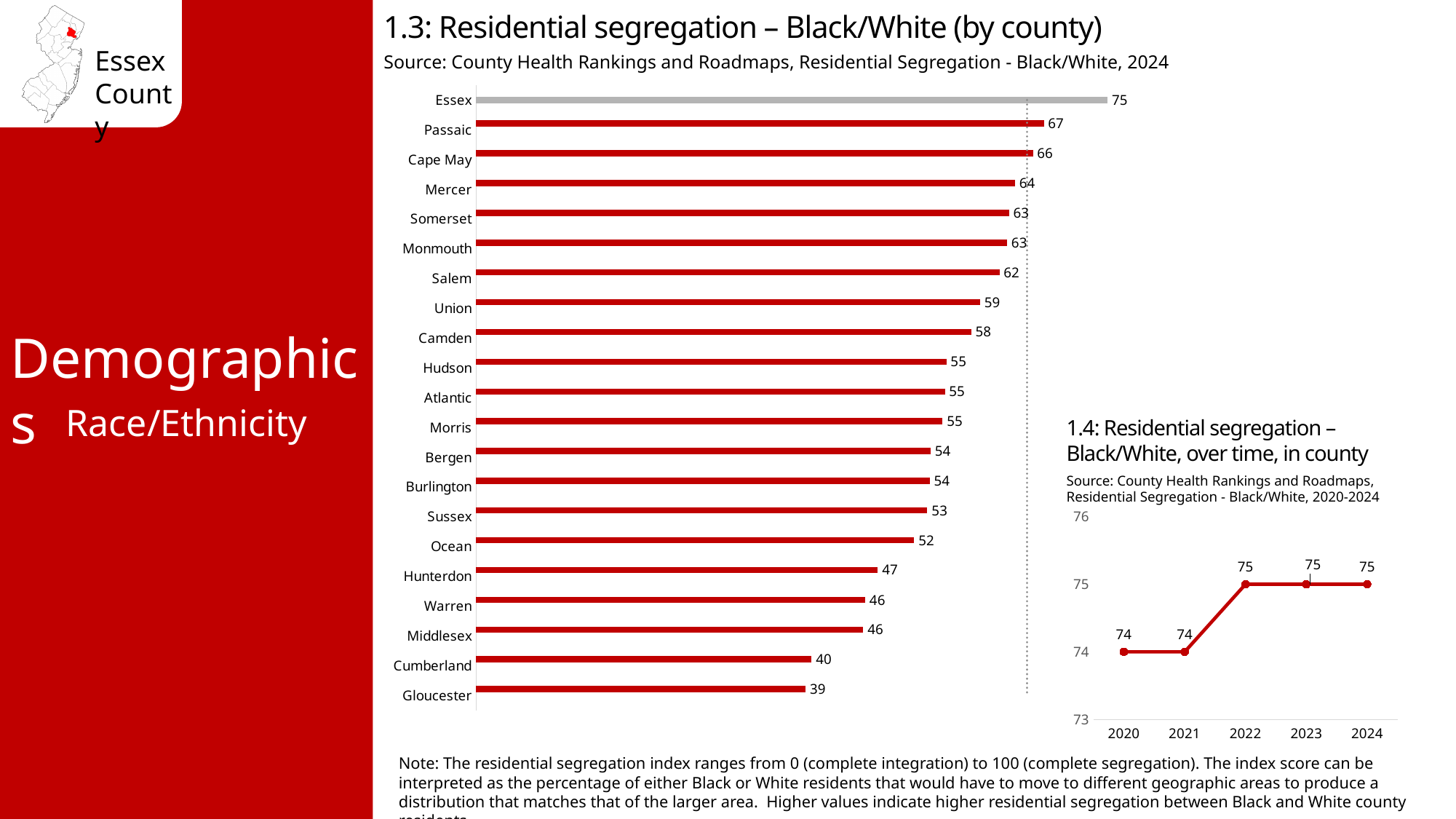
In chart 1.3 (by county), which county has the lowest value? Gloucester In chart 1.3 (by county), what is the value for Gloucester? 39 In chart 1.3 (by county), which has a larger value, Salem or Ocean? Salem In chart 1.3 (Residential segregation – Black/White by county), what is the value for Passaic? 67 In chart 1.3 (by county), how many counties are shown? 21 What kind of chart is chart 1.4 (Residential segregation over time)? Line chart In chart 1.4 (over time), how many years are plotted? 5 In chart 1.3 (by county), which county has the highest value? Essex In chart 1.4 (over time), do the values rise or fall from 2020 to 2024? Rise What kind of chart is chart 1.3 (Residential segregation – Black/White by county)? Bar chart In chart 1.3 (by county), what is the difference between the values for Essex and Cumberland? 35 In chart 1.4 (Residential segregation over time), what is the value for 2021? 74